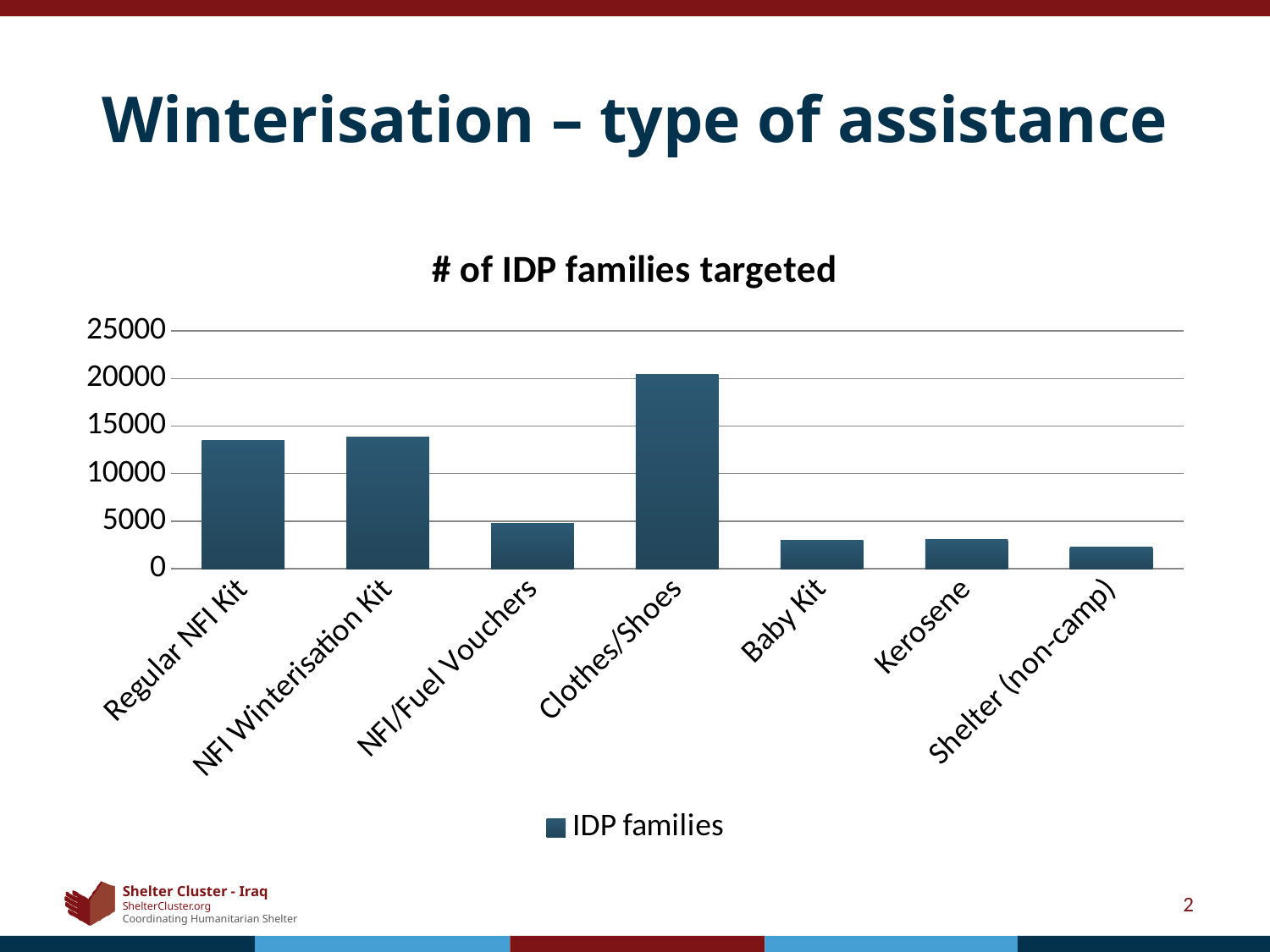
Which type of assistance has the lowest number of IDP families targeted? Shelter (non-camp) Which type of assistance has the highest number of IDP families targeted? Clothes/Shoes Which is larger, the value for Clothes/Shoes or the value for Baby Kit? Clothes/Shoes How many series does the chart's legend list? 1 Is the value for NFI Winterisation Kit greater or less than 15000? less How many categories are shown on the x axis of the chart? 7 What kind of chart is shown on the slide? bar chart What is the name of the series shown in the legend? IDP families Is the value for Regular NFI Kit greater or less than 10000? greater What is the title of the chart? # of IDP families targeted